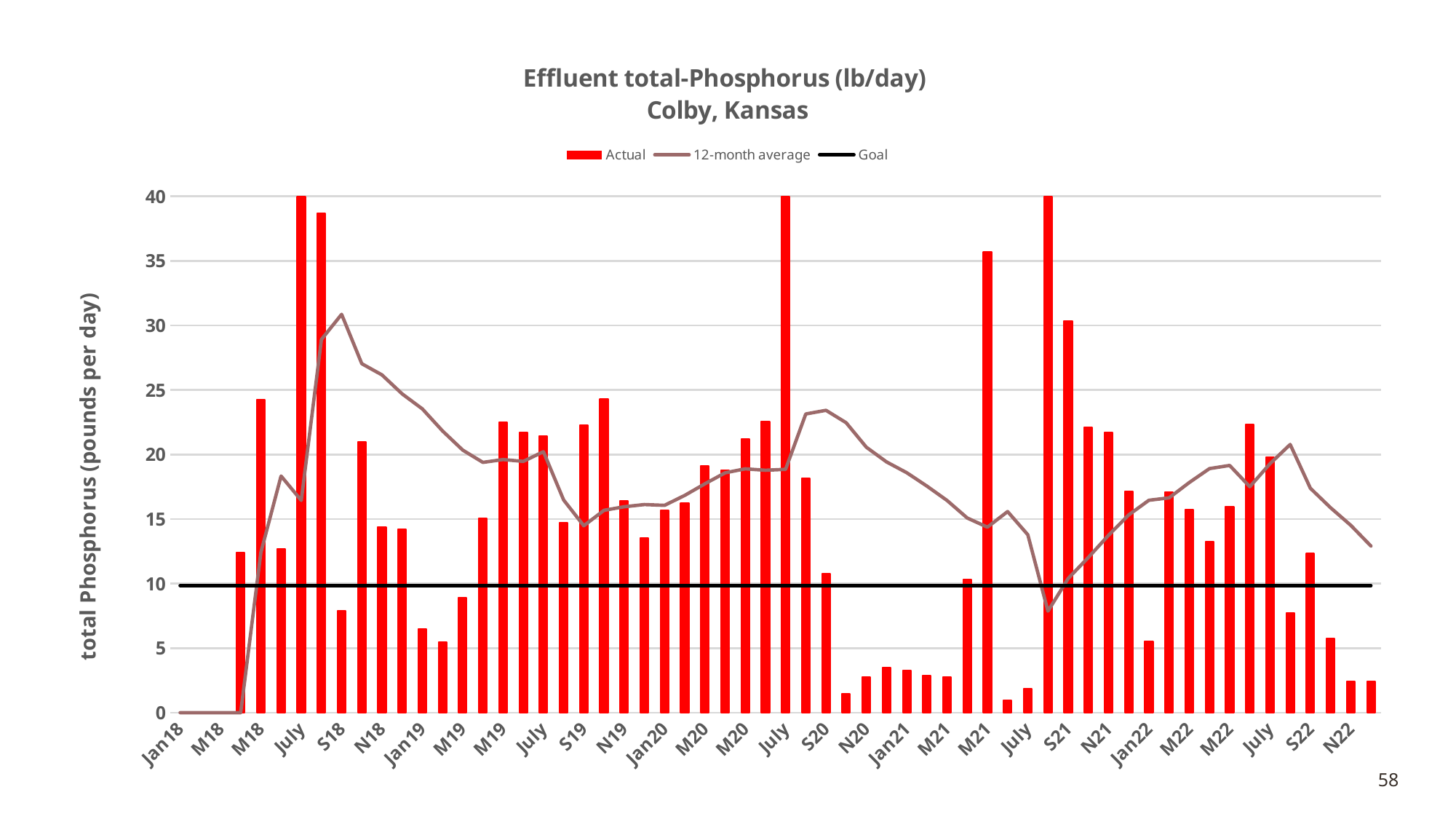
What kind of chart is used to show the Actual values on this slide? bar chart Is the Actual value for S18 greater or less than 10? less Is the Actual value for Jan22 greater or less than 10? less What is the title of the chart? Effluent total-Phosphorus (lb/day) Colby, Kansas Is the Actual value for N22 greater or less than 5? less What is the label on the vertical axis? total Phosphorus (pounds per day) Which has the larger Actual value, Jan20 or N20? Jan20 How many series does the legend list? 3 Does the 12-month average line rise or fall between S20 and Jan21? fall